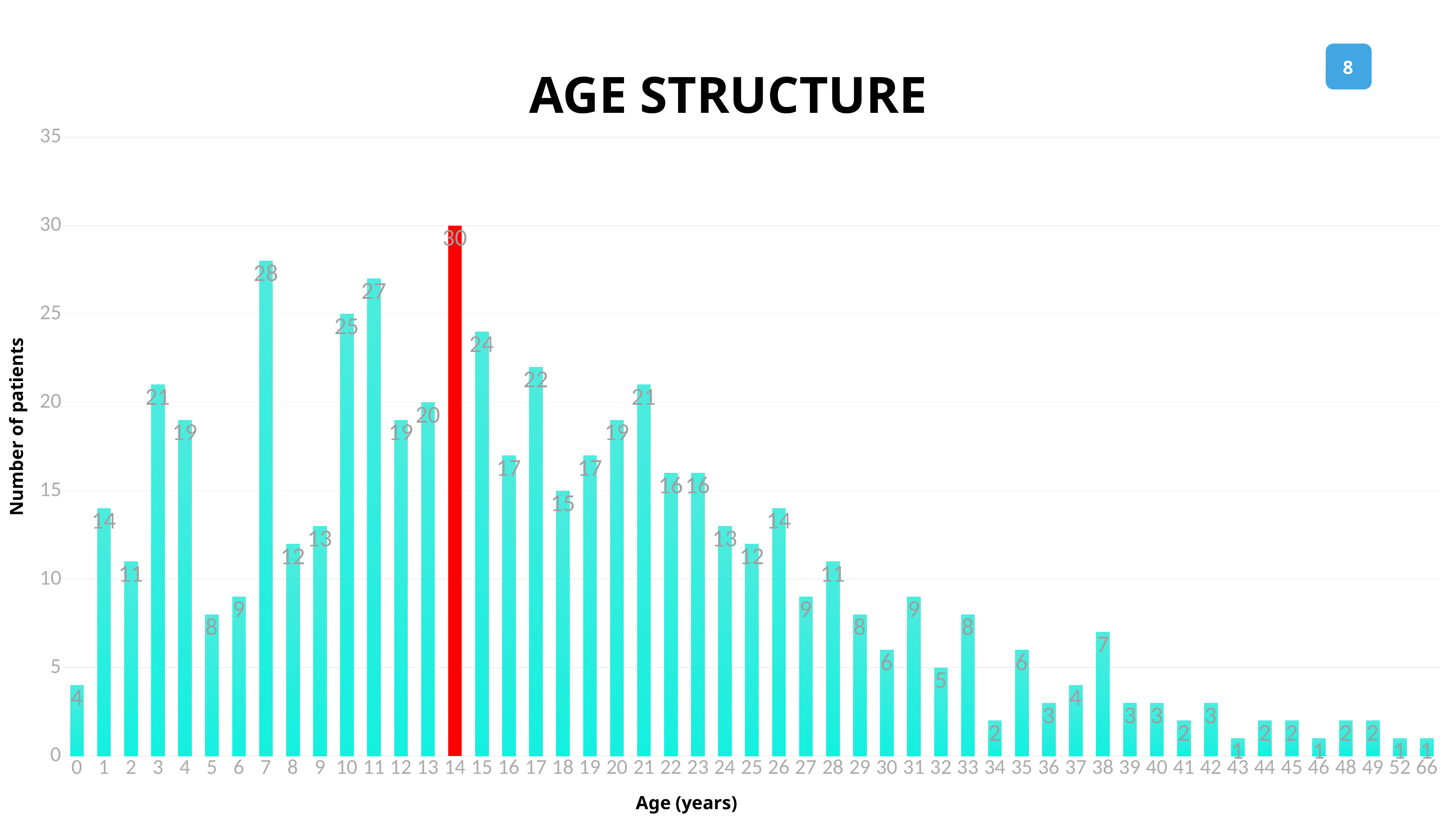
What is the difference in number of patients between age 14 and age 7? 2 Is the number of patients for age 17 greater or less than 20? greater What kind of chart is shown on the slide? bar chart Which has more patients, age 11 or age 15? age 11 Which bar is coloured red instead of cyan? age 14 Which age has the highest number of patients? 14 What is the number of patients for age 21? 21 How many patients are aged 7 years? 28 What is the number of patients at the highest bar? 30 What is the difference in number of patients between age 10 and age 25? 13 How many patients are aged 38 years? 7 How many age categories are shown on the x axis? 51